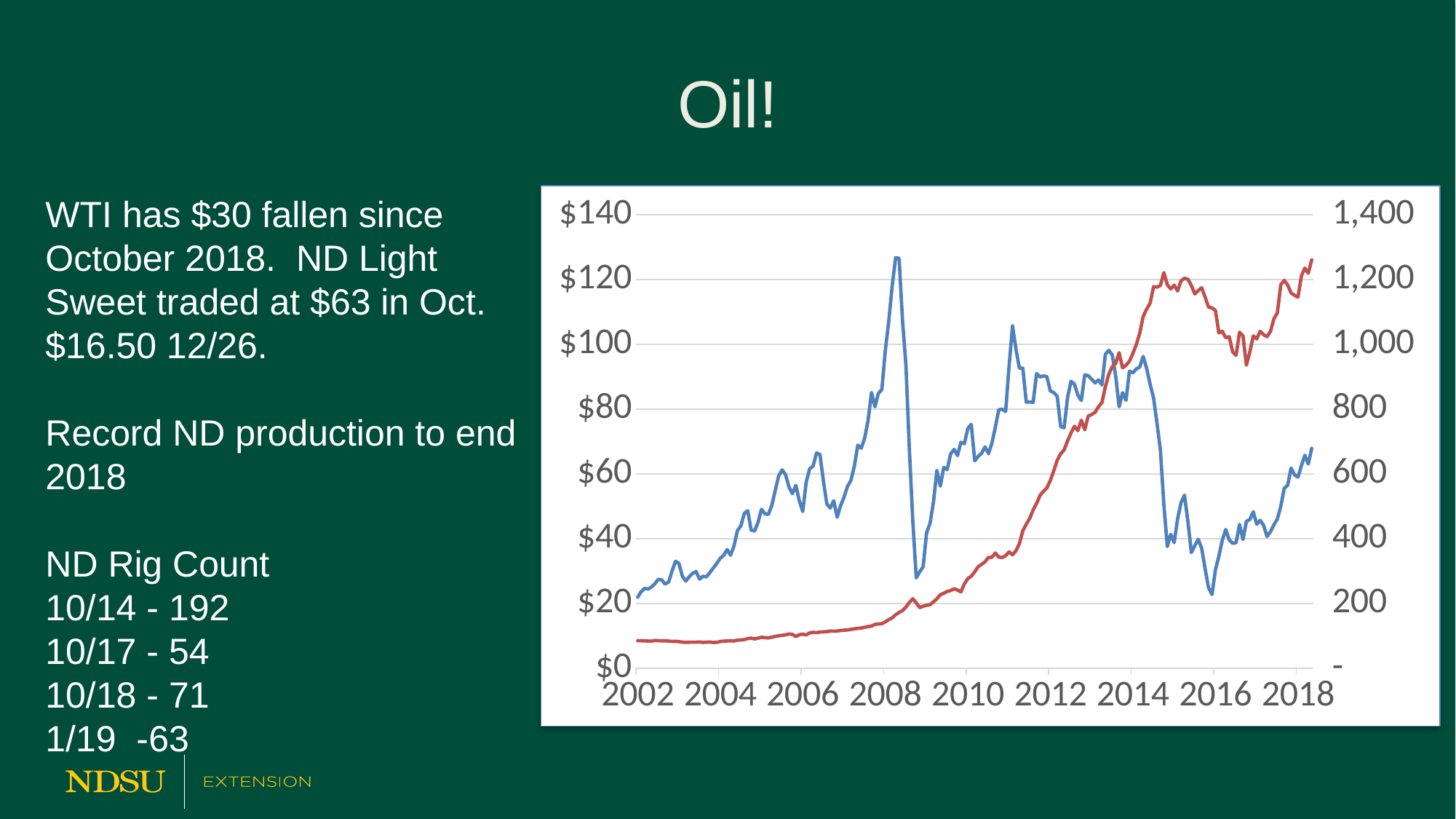
In which year does the blue line reach its highest peak? 2008 How many lines are plotted on the chart? 2 What is the highest value shown on the right vertical axis of the chart? 1,400 Is the red line at the end of 2018 greater or less than 1,000 on the right axis? greater Does the red line generally rise or fall from 2002 to 2018? rise Which line is higher on the chart in 2018, the red line or the blue line? red line Is the lowest point of the blue line around 2016 greater or less than $40 on the left axis? less Is the red line at the start of 2002 greater or less than 200 on the right axis? less What kind of chart is shown on the slide? line chart What is the highest value shown on the left vertical axis of the chart? $140